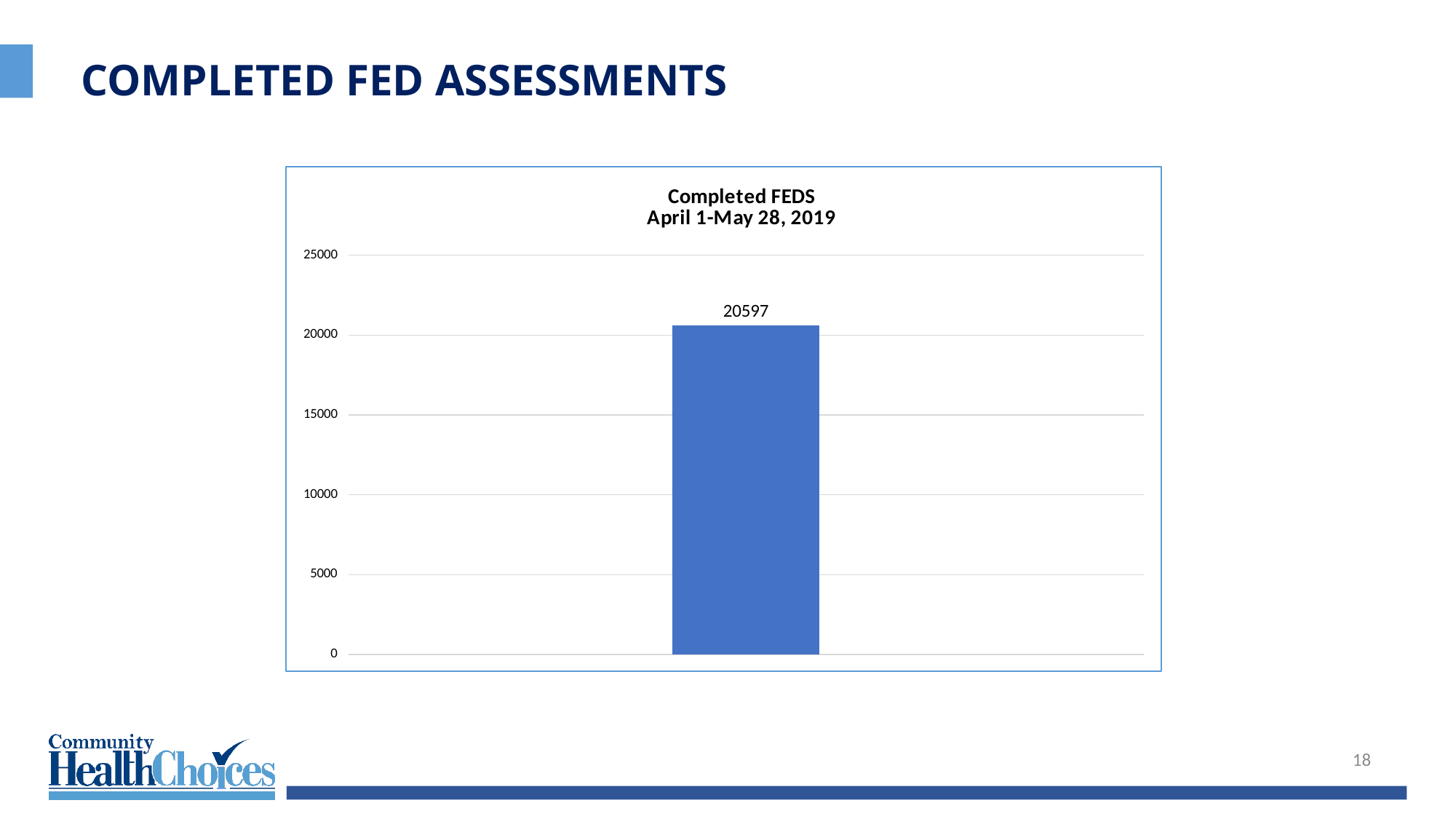
What is the title of the chart? Completed FEDS April 1-May 28, 2019 Is the value of the bar greater or less than 20000? greater Is the value of the bar greater or less than 25000? less What kind of chart is shown on the slide? bar chart What is the highest value shown on the vertical axis? 25000 What value is shown for the single bar in the Completed FEDS chart? 20597 How many bars are plotted in the chart? 1 What date range does the chart title cover? April 1-May 28, 2019